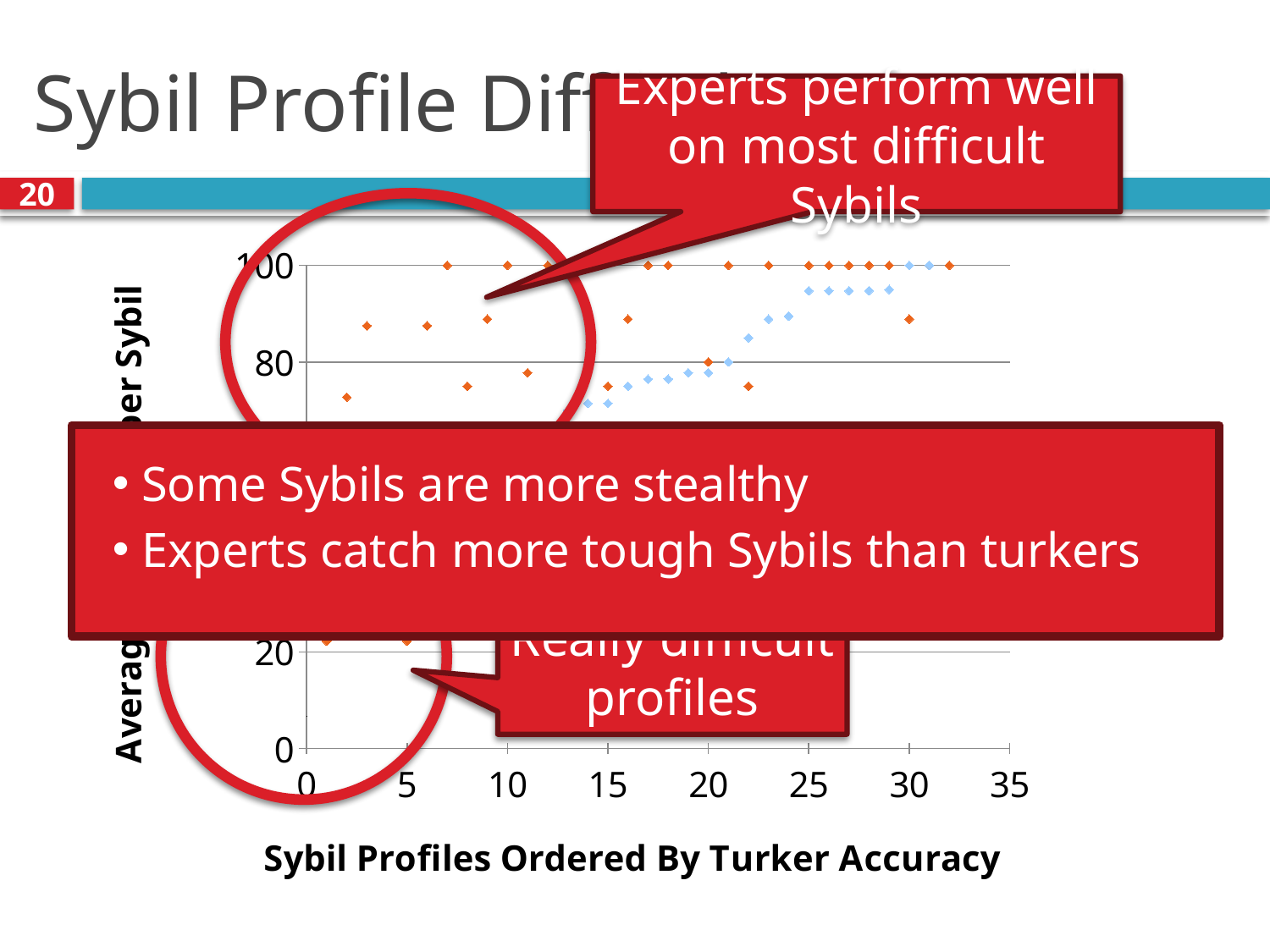
Is the value of the light blue point at x = 32 greater or less than 80? greater How many data series (marker colours) are plotted on the chart? 2 What is the title of the x axis of the chart? Sybil Profiles Ordered By Turker Accuracy What kind of chart is shown on the slide? scatter chart What is the highest tick value shown on the x axis? 35 Do the light blue points rise or fall as the x axis increases? rise Is the value of the orange point at x = 7 greater or less than 80? greater Is the value of the orange point at x = 2 greater or less than 80? less